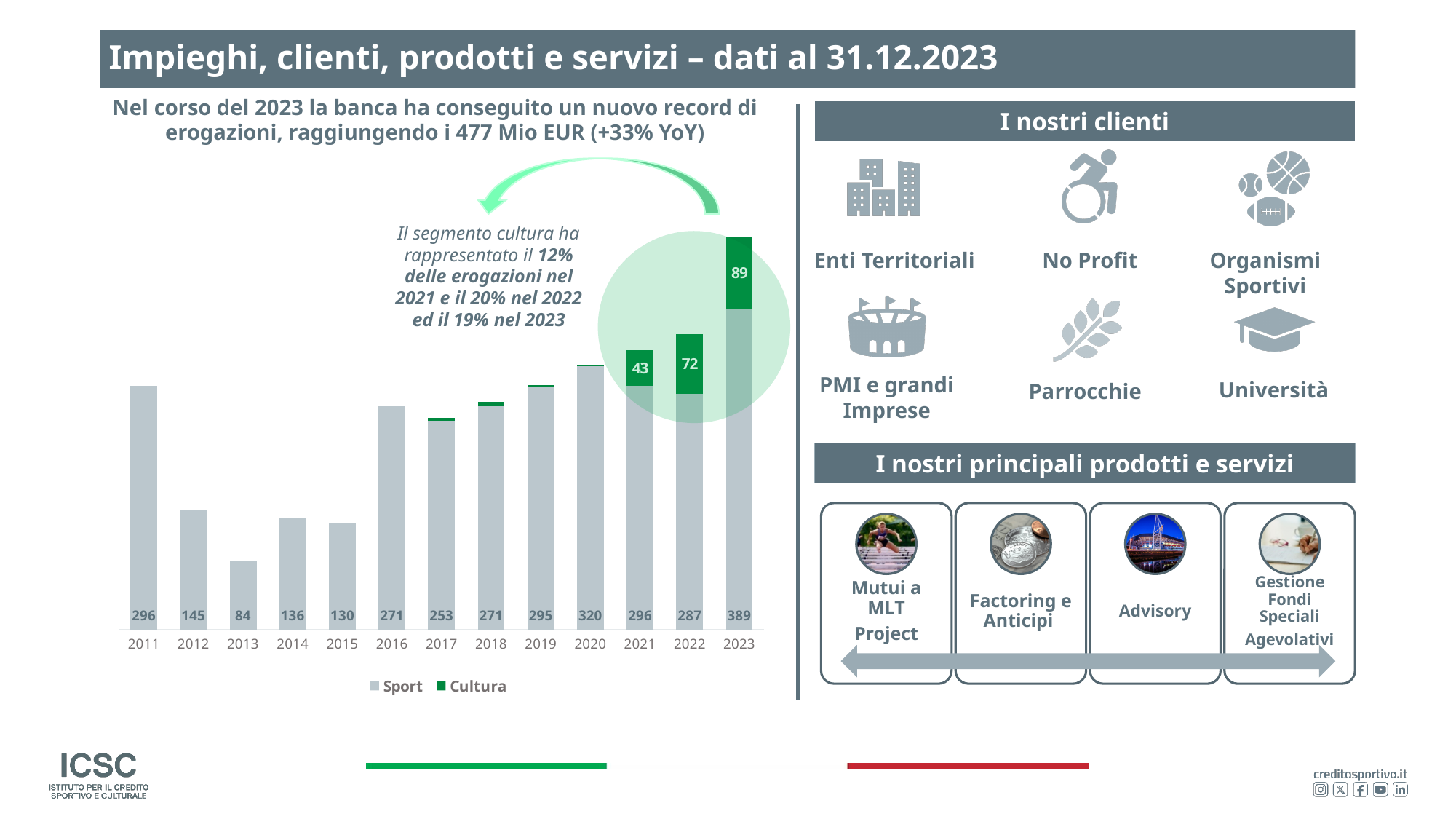
Which year has the lowest Sport value? 2013 What is the Sport value for 2023? 389 How many series does the chart legend list? 2 Which year has the larger Sport value, 2019 or 2020? 2020 Which year has the highest Sport value? 2023 What is the difference between the Sport values for 2023 and 2022? 102 What is the Cultura value for 2021? 43 What is the difference between the Cultura values for 2023 and 2021? 46 What is the total of the stacked bar for 2022 (Sport plus Cultura)? 359 How many years are shown on the x axis of the chart? 13 What is the Cultura value for 2022? 72 What kind of chart is shown on the slide? Stacked bar chart